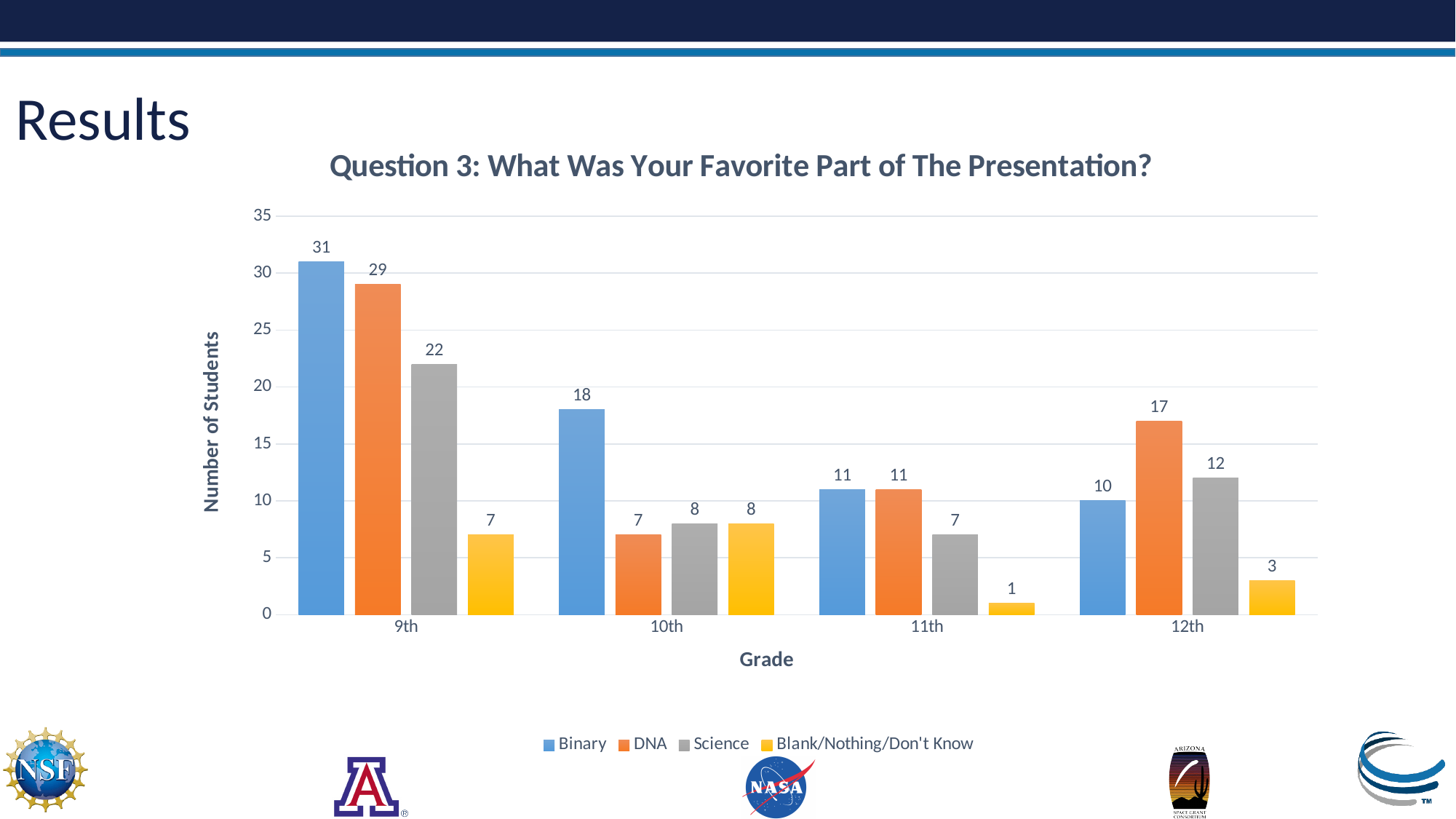
What is the difference between the Binary and DNA values in 9th grade? 2 How many series does the legend list? 4 Which grade has the highest value for Science? 9th What is the title of the chart? Question 3: What Was Your Favorite Part of The Presentation? Do the Binary values rise or fall from 9th grade to 12th grade? Fall What is the value for Blank/Nothing/Don't Know in 11th grade? 1 How many grade categories are shown on the x axis? 4 What kind of chart is shown? Bar chart What is the value for Binary in 9th grade? 31 Which is larger in 12th grade, DNA or Science? DNA What is the value for DNA in 12th grade? 17 Which grade has the lowest value for Binary? 12th